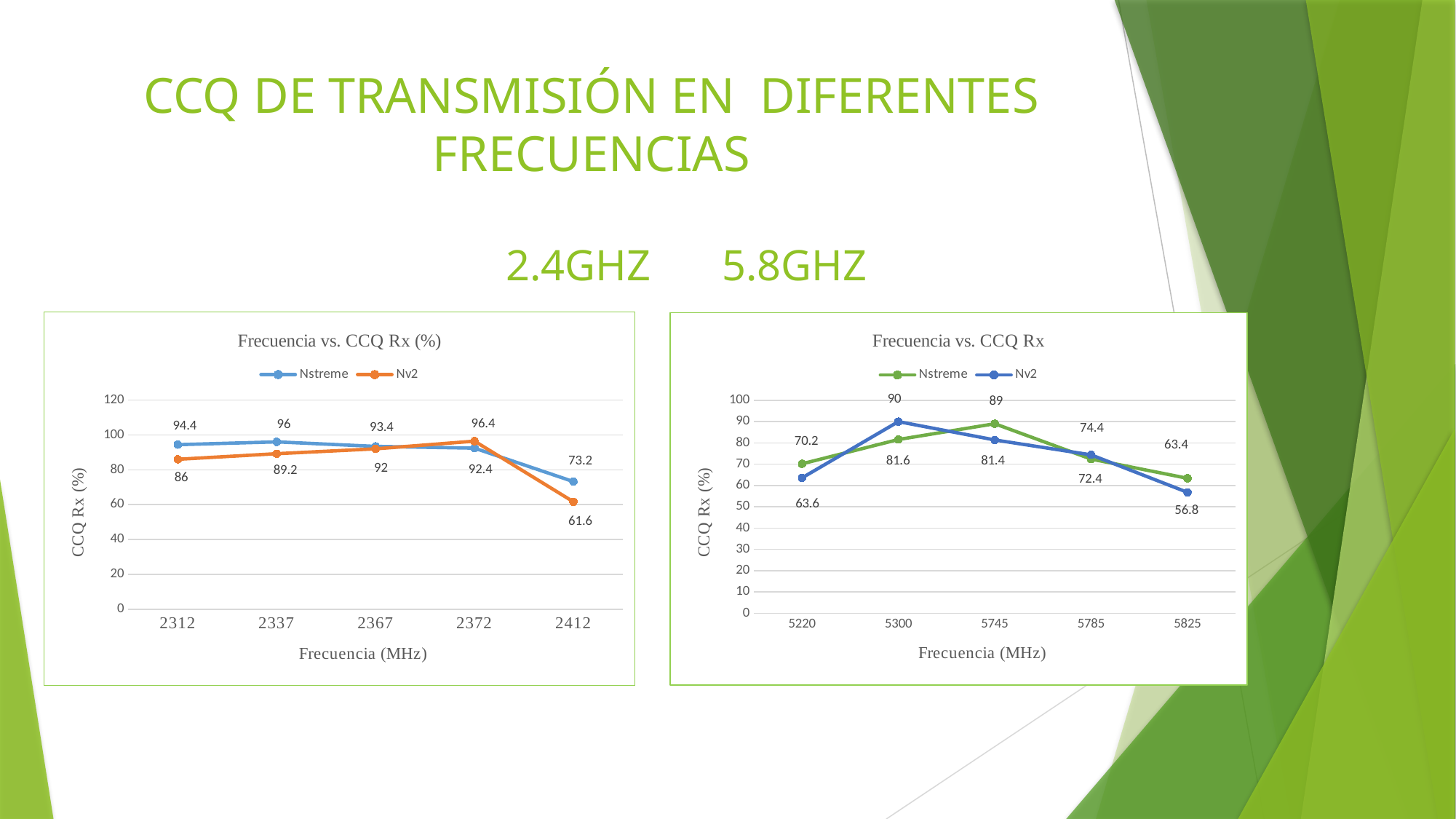
In the left chart (2.4GHz), at which frequency does Nv2 reach its highest value? 2372 How many frequency points are plotted in the left chart (2.4GHz)? 5 In the right chart (5.8GHz), what is the CCQ Rx value for Nv2 at 5300 MHz? 90 In the right chart (5.8GHz), what is the CCQ Rx value for Nstreme at 5745 MHz? 89 In the left chart (2.4GHz), what is the difference between the Nstreme and Nv2 values at 2312 MHz? 8.4 In the right chart (5.8GHz), at which frequency does Nv2 have its lowest value? 5825 In the left chart (2.4GHz), what is the CCQ Rx value for Nv2 at 2412 MHz? 61.6 What kind of chart is the left chart titled 'Frecuencia vs. CCQ Rx (%)'? Line chart In the right chart (5.8GHz), which series has the larger value at 5220 MHz, Nstreme or Nv2? Nstreme In the right chart (5.8GHz), what is the difference between the Nstreme values at 5300 MHz and 5825 MHz? 18.2 In the left chart (2.4GHz), what is the CCQ Rx value for Nstreme at 2337 MHz? 96 How many series does the legend of the right chart (5.8GHz) list? 2